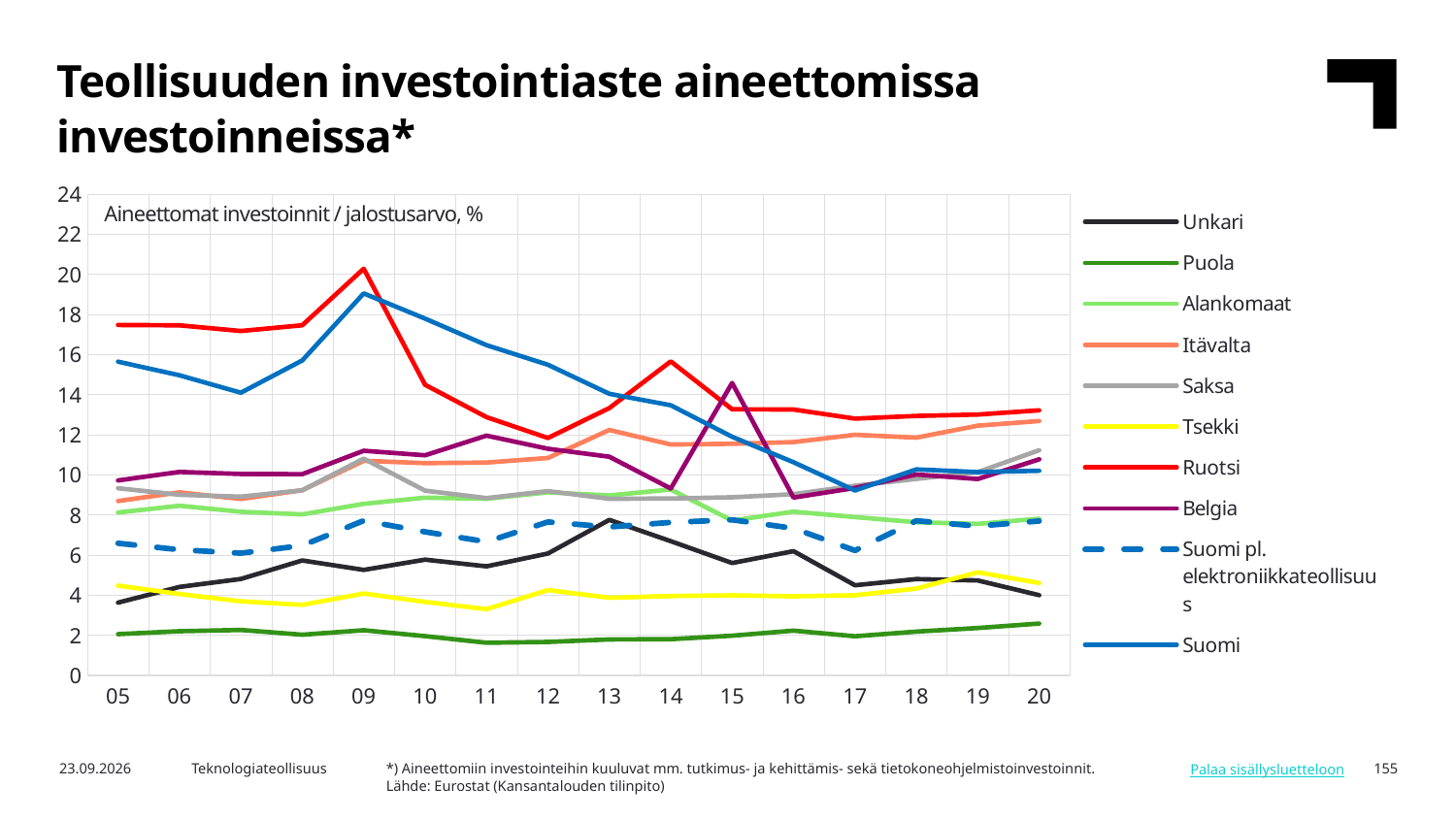
Is the value for Puola in 20 greater or less than 4? less Is the value for Ruotsi in 05 greater or less than 16? greater How many years are plotted along the x axis? 16 What kind of chart is shown on the slide? line chart How many series does the legend list? 10 Is the value for Tsekki in 11 greater or less than 4? less Which is larger in 15, the value for Belgia or the value for Saksa? Belgia Which series has the lowest value in 05? Puola Which series has the highest value in 05? Ruotsi Does the value for Suomi rise or fall from 09 to 17? fall Which series is drawn with a dashed line? Suomi pl. elektroniikkateollisuus